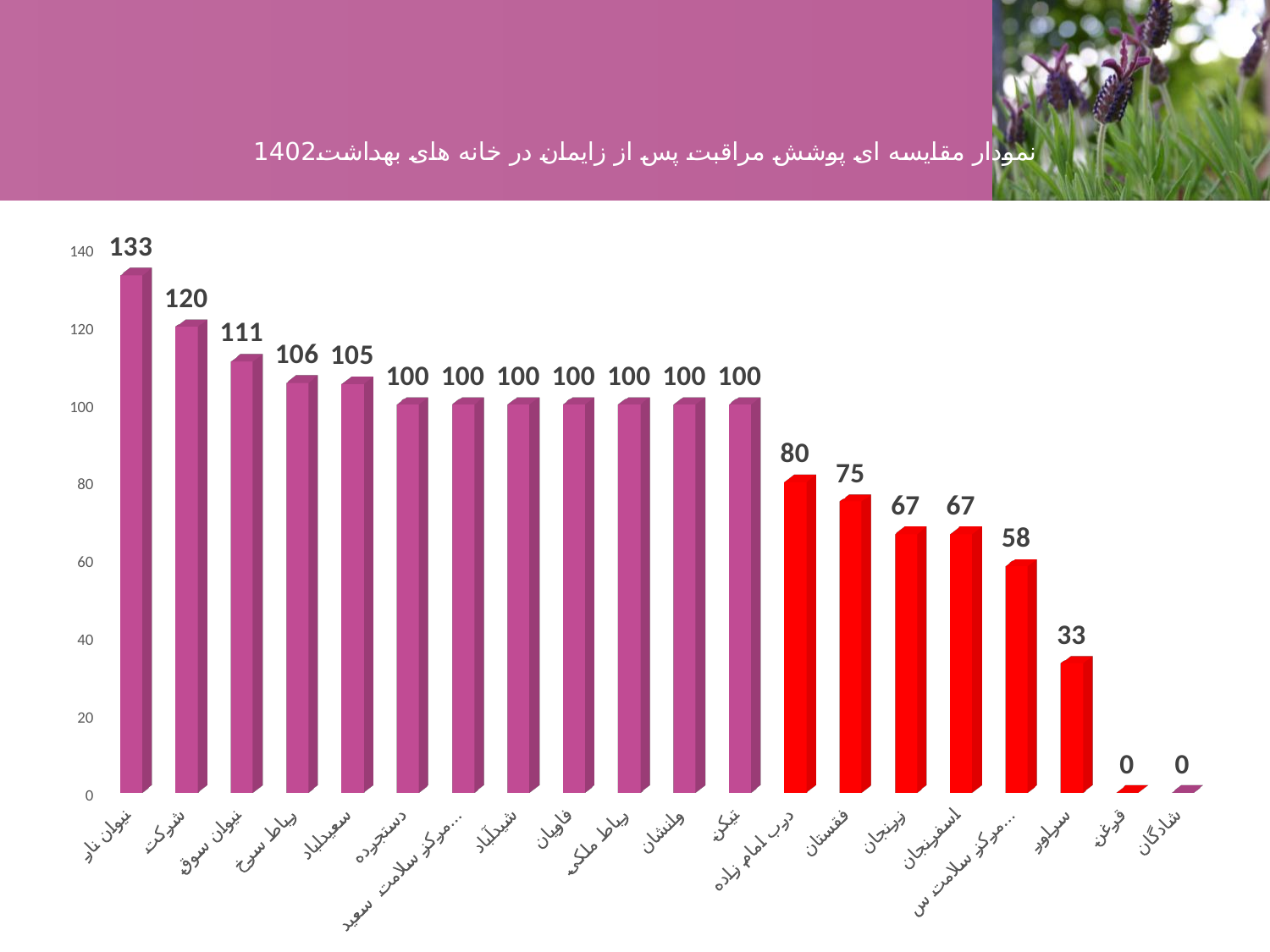
Which is larger, the value for سعیدآباد or the value for فقستان? سعیدآباد What colour are the bars with values below 100? red How many bars have a value of exactly 100? 7 What is the value for درب امام زاده? 80 How many categories are shown on the x axis? 20 What is the value for فقستان? 75 Which category has the highest value? نیوان نار What is the lowest value shown in the chart? 0 What type of chart is shown on the slide? bar chart What is the difference between the values for نیوان نار and شرکت? 13 What is the value for شرکت? 120 What is the value for سیاور? 33